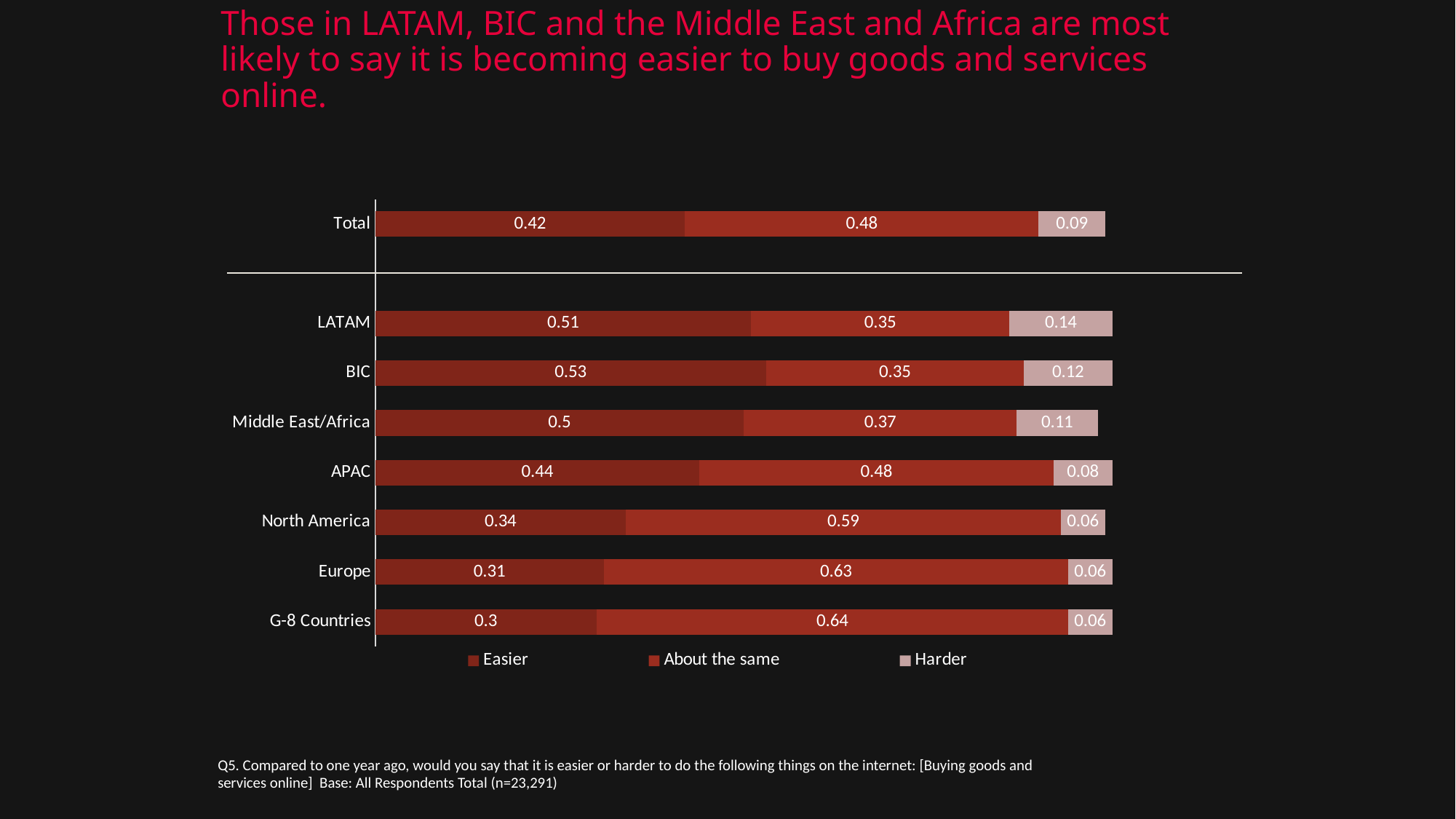
What is the difference between the 'About the same' values for G-8 Countries and LATAM? 0.29 Which region has the highest 'Easier' value? BIC How many categories (bars) are shown in the chart? 8 What is the 'Easier' value for LATAM? 0.51 What is the 'Harder' value for Total? 0.09 What is the 'About the same' value for North America? 0.59 What is the total of the stacked bar for Europe? 1 Which is larger, the 'Easier' value for APAC or for Middle East/Africa? Middle East/Africa Which category has the highest 'Harder' value? LATAM What kind of chart is shown on the slide? Stacked bar chart Which category has the lowest 'Easier' value? G-8 Countries How many series does the legend list? 3